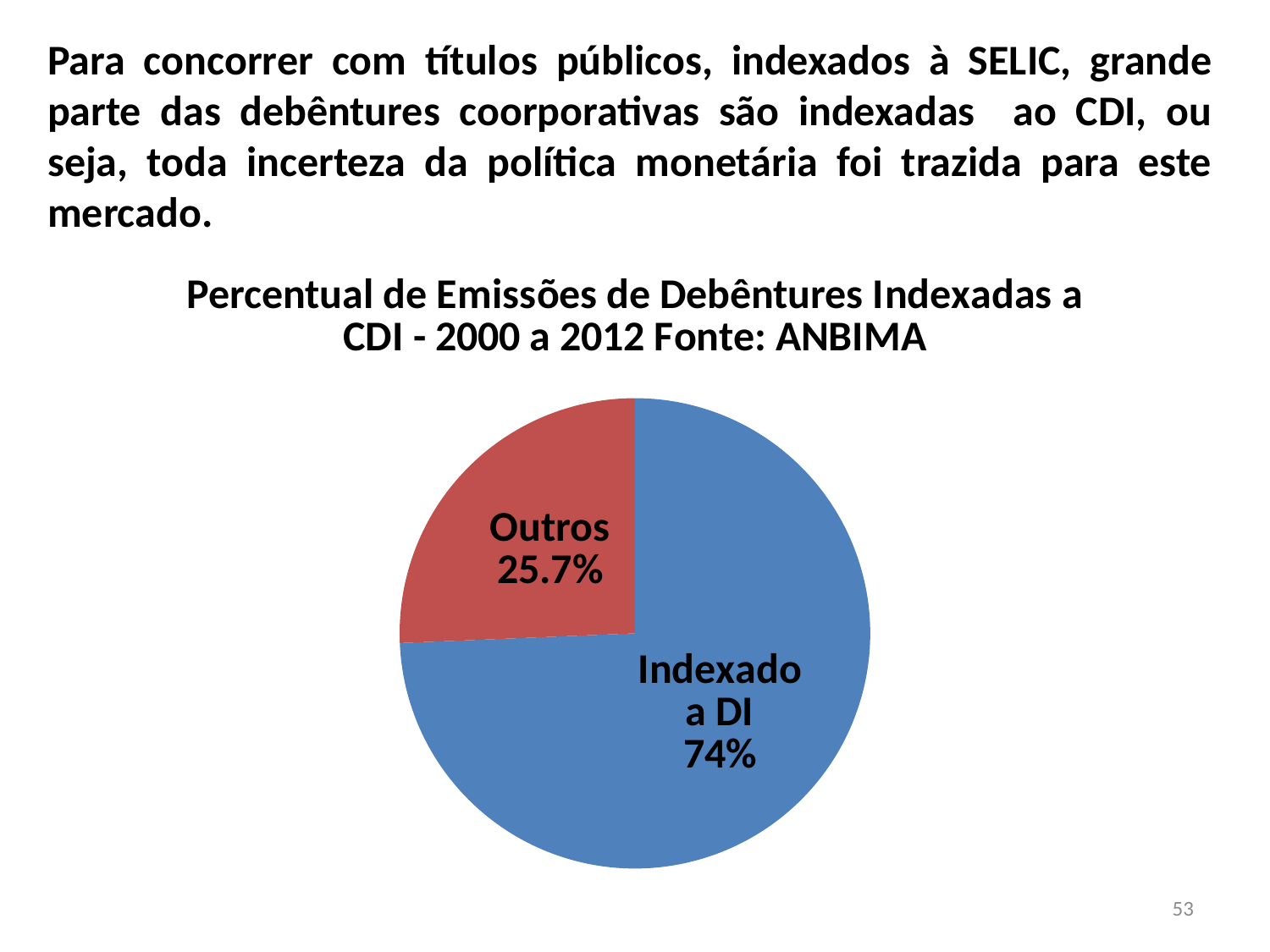
What is the value shown for the "Indexado a DI" slice? 74% How many slices does the pie chart have? 2 What is the value shown for the "Outros" slice? 25.7% Which is larger, the "Indexado a DI" slice or the "Outros" slice? Indexado a DI What share of the pie does the "Indexado a DI" slice represent? 74% What share of the pie does the "Outros" slice represent? 25.7% What kind of chart is shown on the slide? pie chart What is the title of the chart? Percentual de Emissões de Debêntures Indexadas a CDI - 2000 a 2012 Fonte: ANBIMA Which slice of the pie is the largest? Indexado a DI Which slice of the pie is the smallest? Outros What colour is the "Outros" slice? red